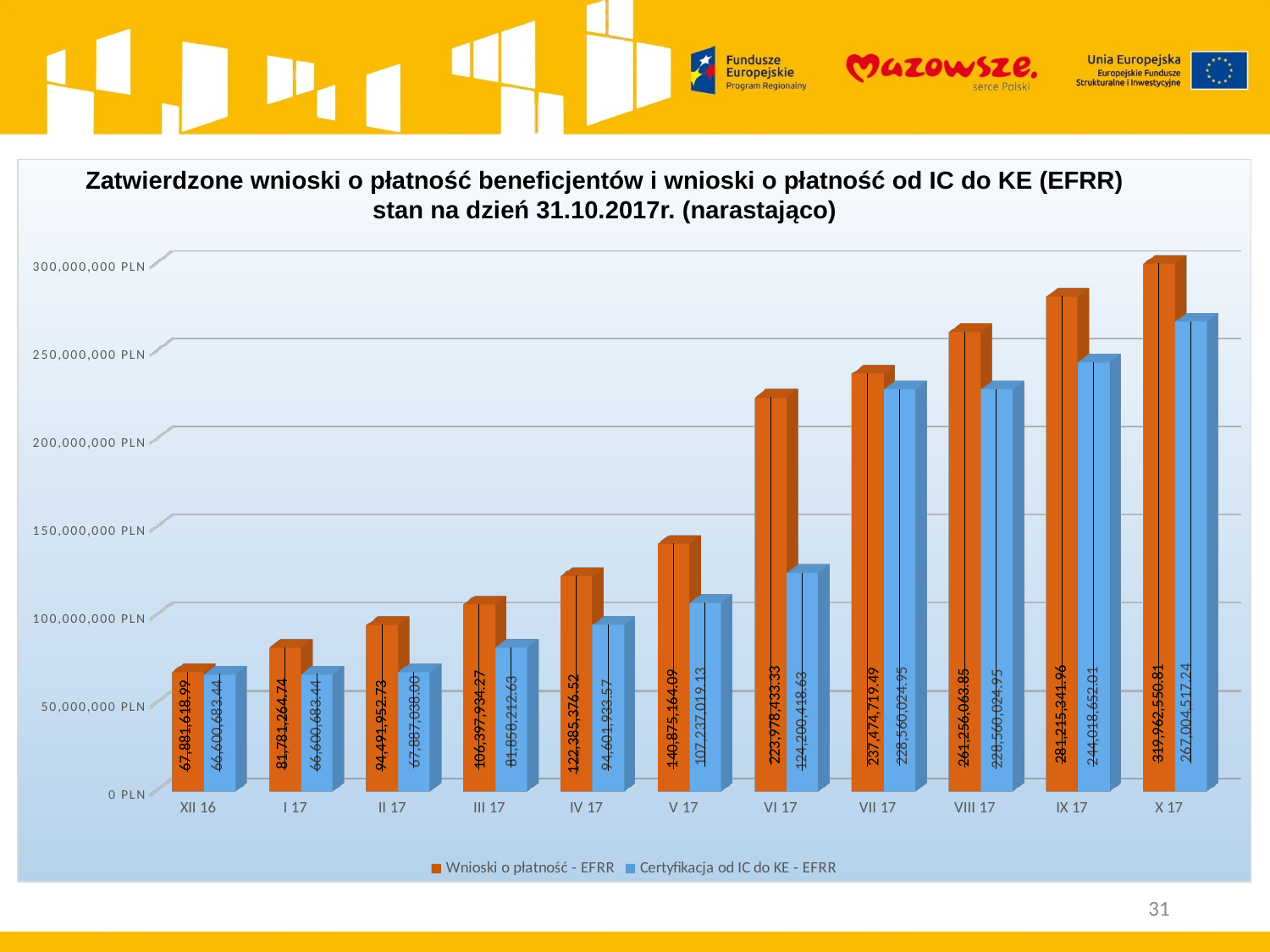
How many series does the legend list? 2 What type of chart is shown on the slide? bar chart Do the values of 'Wnioski o płatność - EFRR' rise or fall from XII 16 to X 17? rise What is the difference between 'Wnioski o płatność - EFRR' and 'Certyfikacja od IC do KE - EFRR' for X 17? 52,958,033.57 Which is larger for VI 17: 'Wnioski o płatność - EFRR' or 'Certyfikacja od IC do KE - EFRR'? Wnioski o płatność - EFRR What is the value of 'Wnioski o płatność - EFRR' for VI 17? 223,978,433.33 In which period is 'Wnioski o płatność - EFRR' the highest? X 17 What is the value of 'Certyfikacja od IC do KE - EFRR' for IX 17? 244,018,652.01 How many time periods (categories) are shown on the x axis? 11 What is the value of 'Wnioski o płatność - EFRR' for X 17? 319,962,550.81 Is the value of 'Certyfikacja od IC do KE - EFRR' for VII 17 greater or less than 200,000,000 PLN? greater In which period is 'Wnioski o płatność - EFRR' the lowest? XII 16